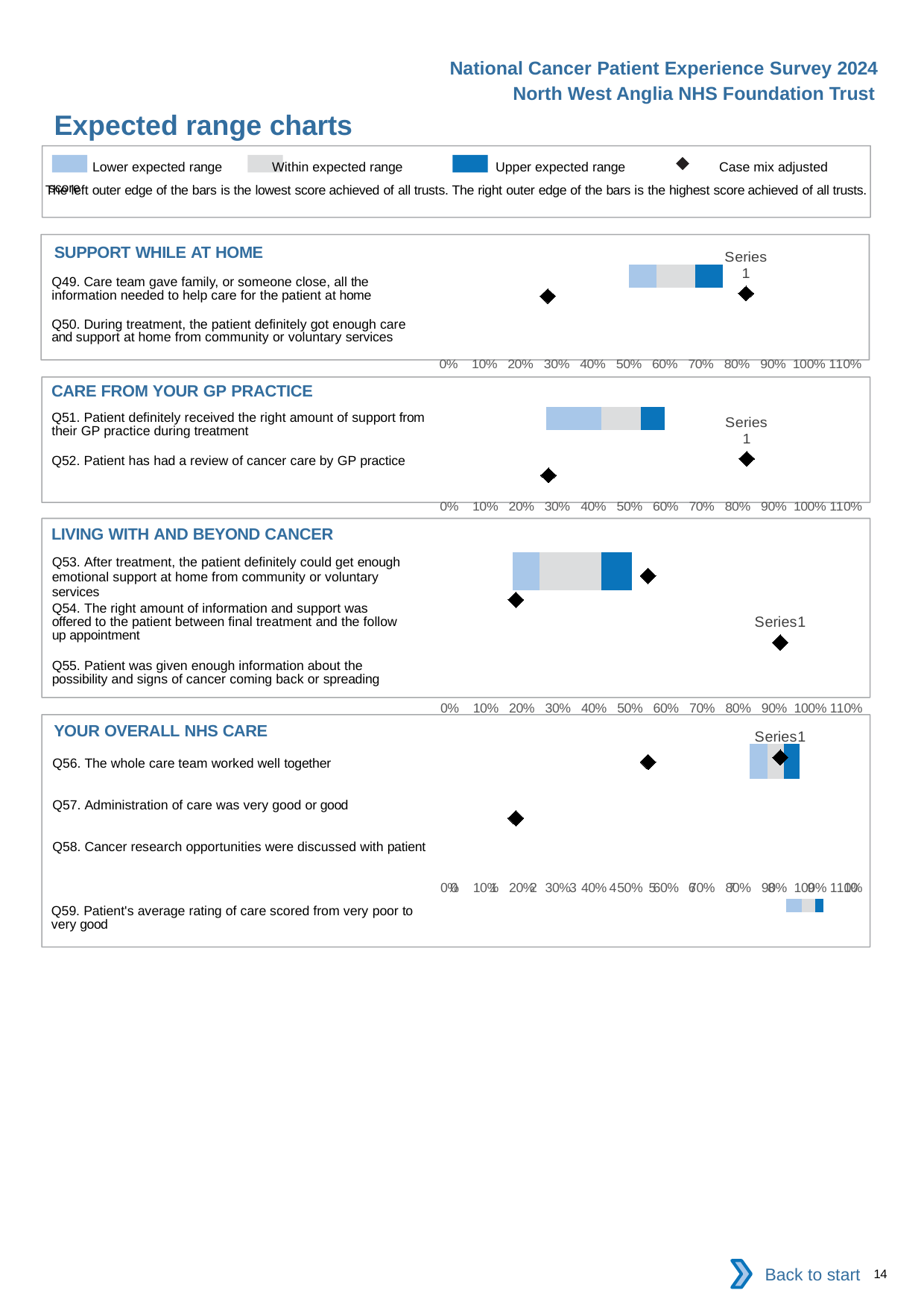
In the SUPPORT WHILE AT HOME chart, is the right edge of the expected range bar greater or less than 60%? greater How many expected range charts are shown on the slide? 4 In the LIVING WITH AND BEYOND CANCER chart, is the right edge of the expected range bar greater or less than 70%? less How many entries does the legend at the top of the slide list? 4 According to the legend, which colour represents the upper expected range? dark blue In the CARE FROM YOUR GP PRACTICE chart, is the left edge of the expected range bar greater or less than 20%? greater What kind of chart is used in the SUPPORT WHILE AT HOME section? bar chart How many questions are listed in the CARE FROM YOUR GP PRACTICE chart? 2 How many questions are listed in the LIVING WITH AND BEYOND CANCER chart? 3 According to the legend, what does the black diamond marker represent? Case mix adjusted score